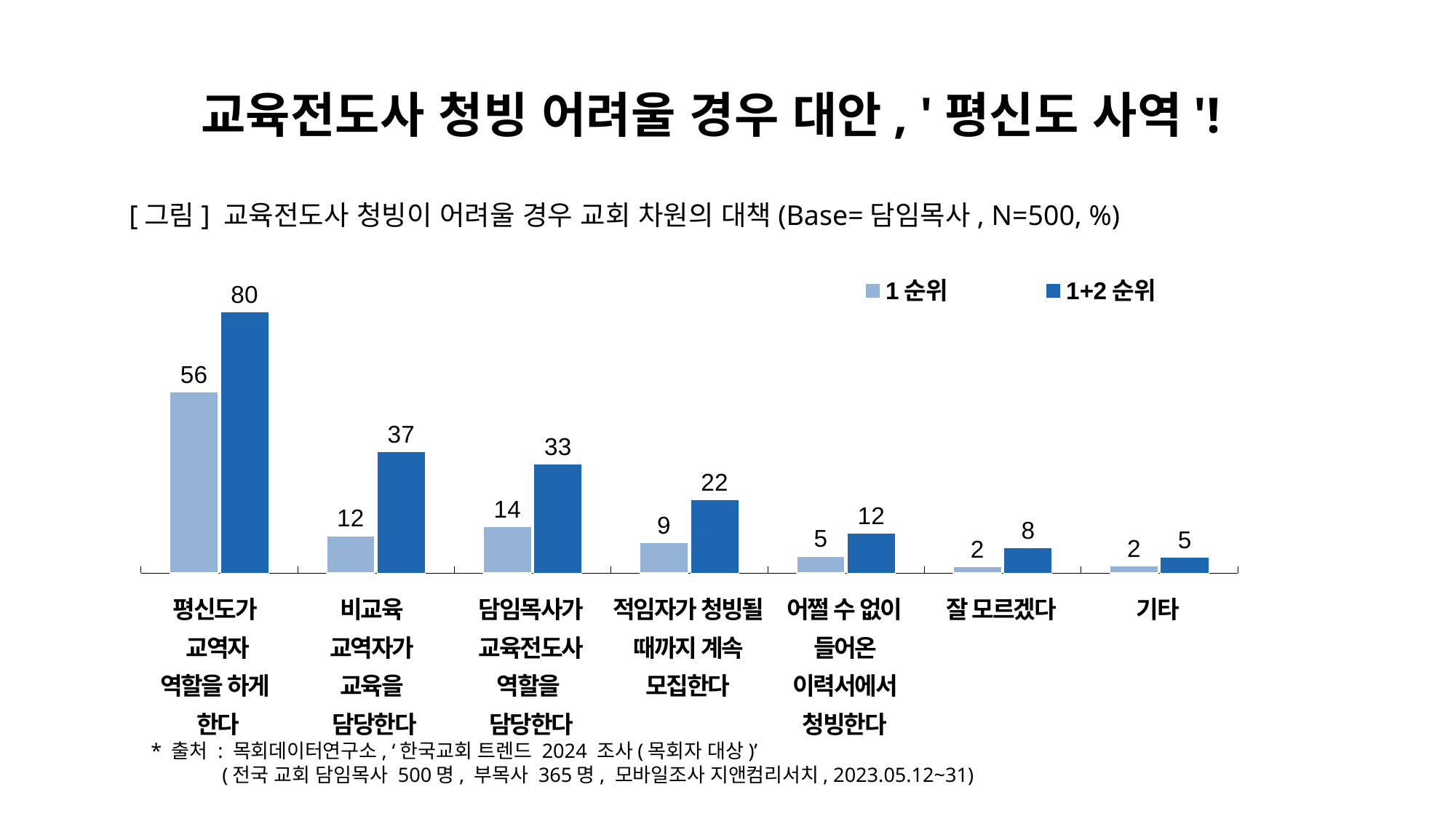
What is the difference between the 1+2 순위 and 1 순위 values for 담임목사가 교육전도사 역할을 담당한다? 19 What kind of chart is shown on the slide? Bar chart What is the 1+2 순위 value for 적임자가 청빙될 때까지 계속 모집한다? 22 Which is larger: the 1+2 순위 value for 비교육 교역자가 교육을 담당한다 or for 담임목사가 교육전도사 역할을 담당한다? 비교육 교역자가 교육을 담당한다 Which category has the highest 1 순위 value? 평신도가 교역자 역할을 하게 한다 How many series does the legend list? 2 What are the two series names listed in the legend? 1 순위, 1+2 순위 Which category has the lowest 1+2 순위 value? 기타 How many categories are shown on the x axis? 7 Do the 1+2 순위 values rise or fall from left to right across the categories? Fall What is the 1+2 순위 value for 평신도가 교역자 역할을 하게 한다? 80 What is the 1 순위 value for 비교육 교역자가 교육을 담당한다? 12